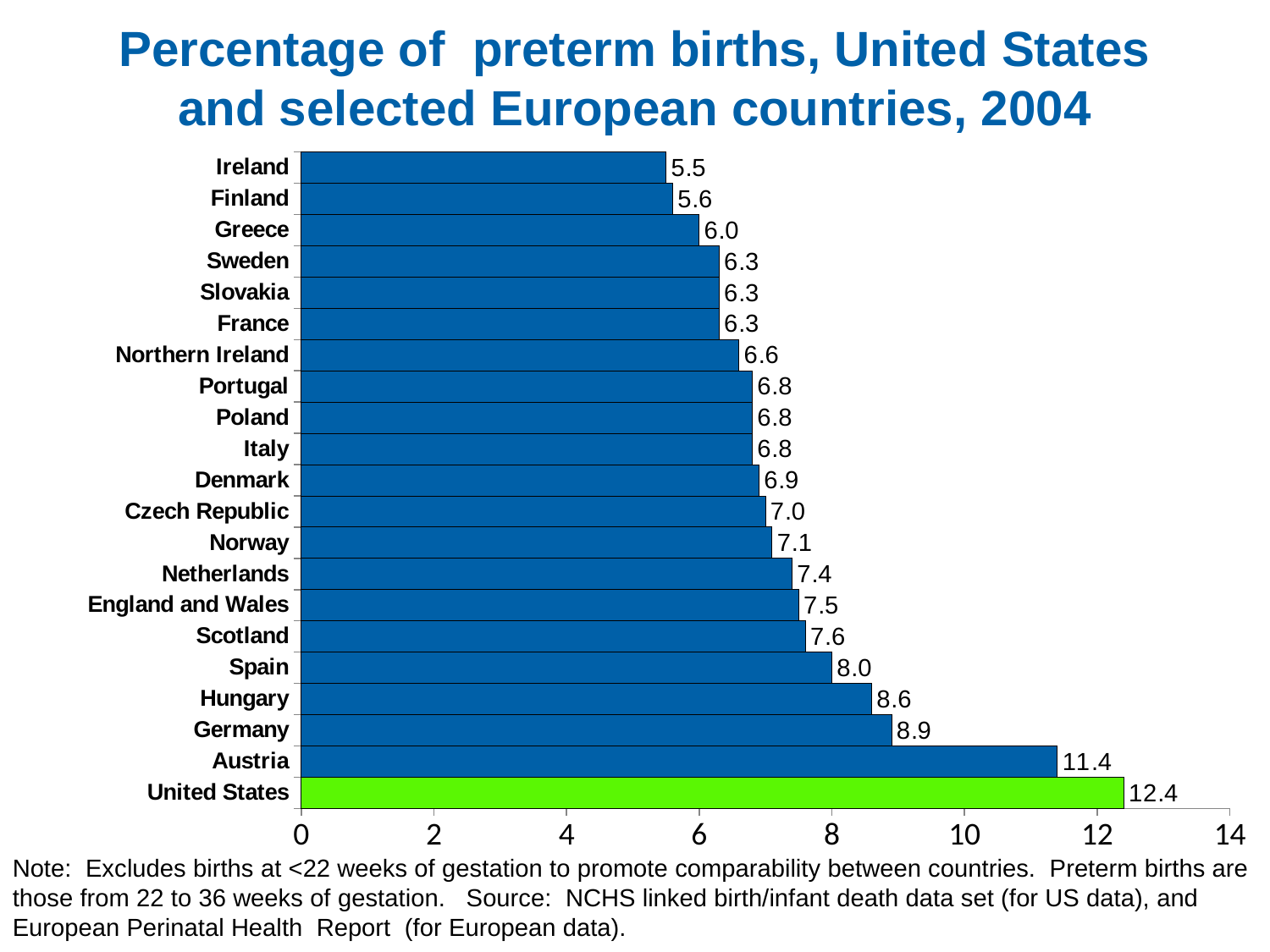
Which country has the highest percentage of preterm births? United States What is the difference between the percentage of preterm births for the United States and Austria? 1.0 Which country has the lowest percentage of preterm births? Ireland Which country's bar is coloured green instead of blue? United States What is the difference between the percentage of preterm births for Germany and Ireland? 3.4 Is the value for Scotland greater or less than 8? less What is the percentage of preterm births for the United States? 12.4 How many countries are shown in the chart? 21 What is the percentage of preterm births for Austria? 11.4 What is the percentage of preterm births for Northern Ireland? 6.6 What kind of chart is shown on the slide? bar chart Which has a higher percentage of preterm births, Hungary or Spain? Hungary